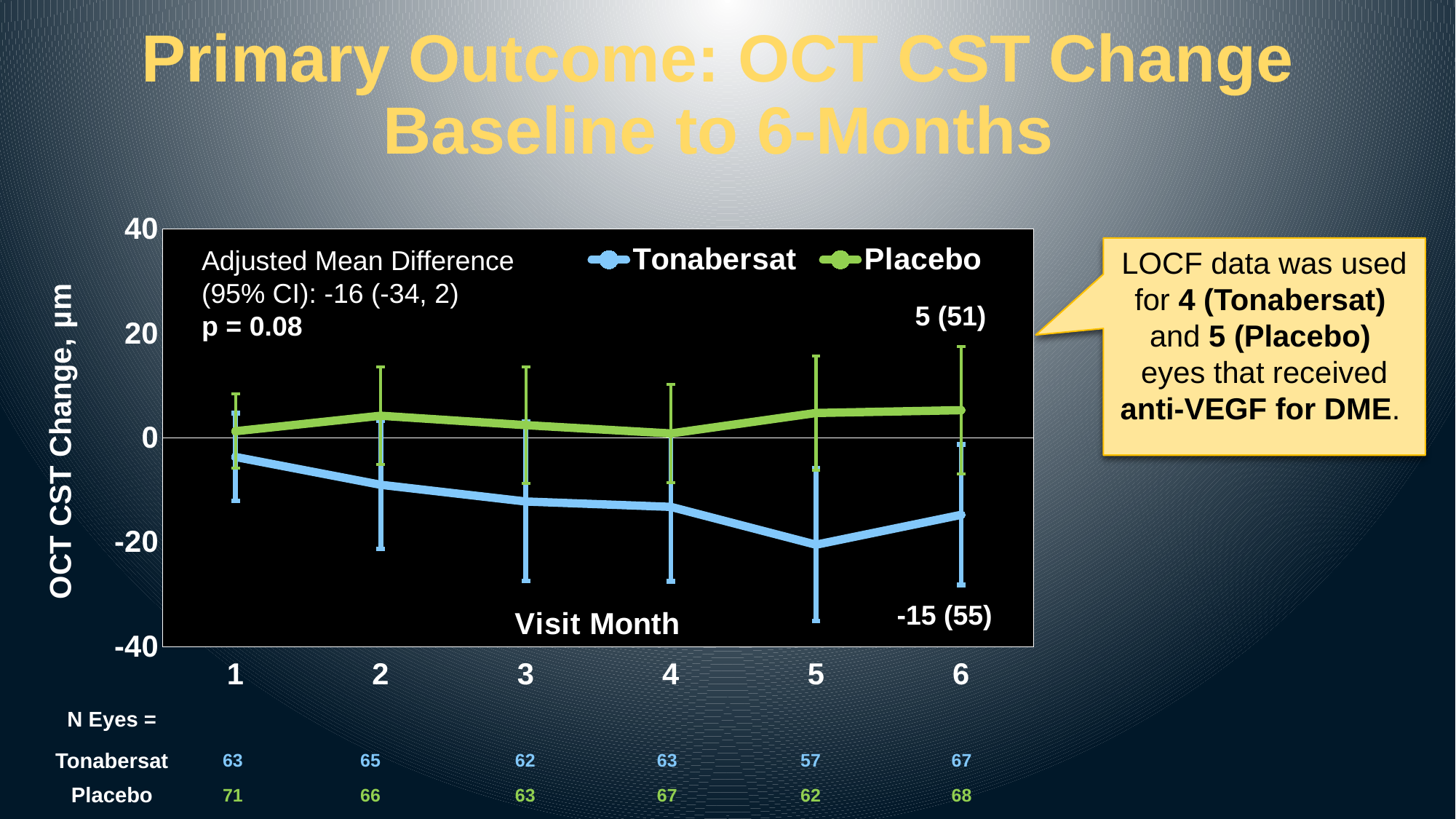
Is the Tonabersat value at visit month 5 greater or less than -10? less At which visit month does the Tonabersat series reach its lowest value? 5 What data label is shown for Tonabersat at visit month 6? -15 (55) At visit month 6, which series has the higher OCT CST change value, Tonabersat or Placebo? Placebo What is the y-axis title of the chart? OCT CST Change, µm How many visit months are plotted on the x axis? 6 Is the Placebo value at visit month 2 greater or less than 0? greater What type of chart is shown on the slide? line chart What data label is shown for Placebo at visit month 6? 5 (51) How many series does the chart legend list? 2 Does the Tonabersat series rise or fall from visit month 1 to visit month 5? fall What is the difference between the Placebo and Tonabersat OCT CST change values at visit month 6? 20